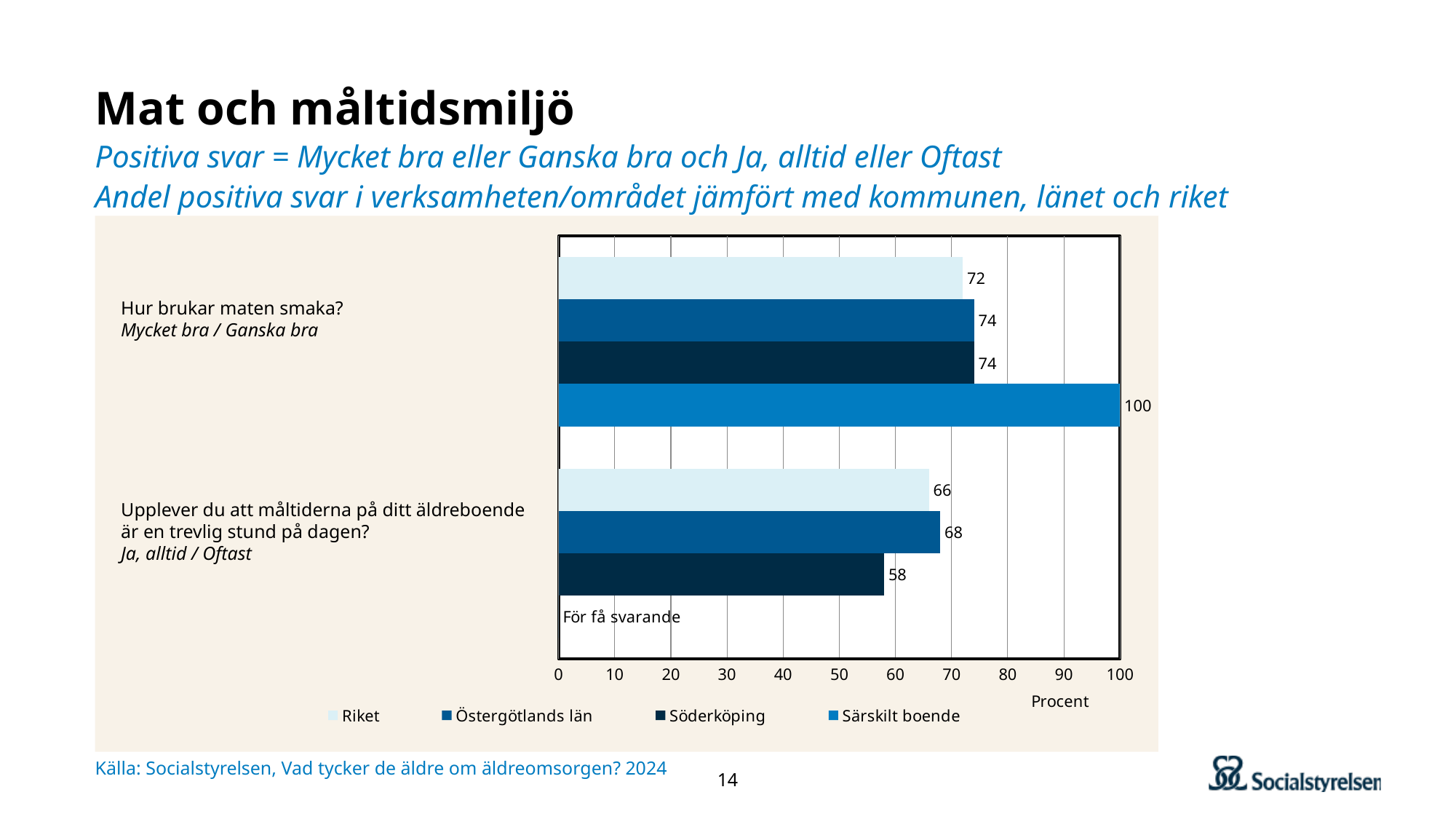
For the question "Upplever du att måltiderna på ditt äldreboende är en trevlig stund på dagen?", which is larger: the value for Riket or the value for Söderköping? Riket What is the difference between the Östergötlands län value and the Söderköping value for the question "Upplever du att måltiderna på ditt äldreboende är en trevlig stund på dagen?"? 10 What is the value for Särskilt boende for the question "Hur brukar maten smaka?"? 100 What kind of chart is shown on the slide? Bar chart Which series has the lowest value for the question "Upplever du att måltiderna på ditt äldreboende är en trevlig stund på dagen?"? Söderköping What is the value for Söderköping for the question "Upplever du att måltiderna på ditt äldreboende är en trevlig stund på dagen?"? 58 What is the value for Riket for the question "Hur brukar maten smaka?"? 72 What is the difference between the Särskilt boende value and the Riket value for the question "Hur brukar maten smaka?"? 28 What is the value for Östergötlands län for the question "Upplever du att måltiderna på ditt äldreboende är en trevlig stund på dagen?"? 68 What is shown instead of a bar for Särskilt boende for the question "Upplever du att måltiderna på ditt äldreboende är en trevlig stund på dagen?"? För få svarande Which series has the highest value for the question "Hur brukar maten smaka?"? Särskilt boende How many series does the legend list? 4